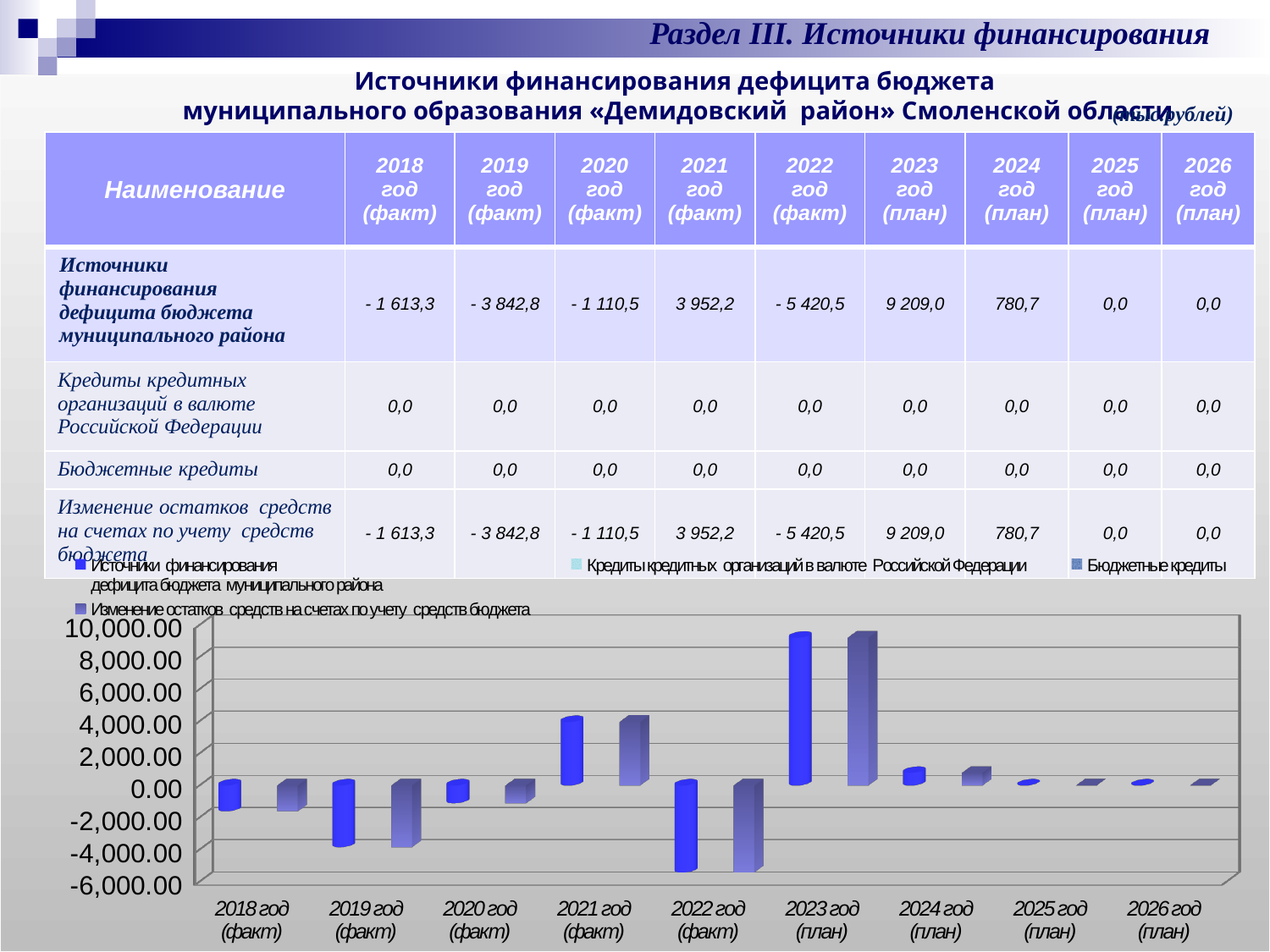
What is the highest tick value shown on the chart's vertical axis? 10,000.00 What kind of chart is shown at the bottom of the slide? bar chart In which year category do the bars reach their highest value? 2023 год (план) Is the value for 2023 год (план) greater or less than 8,000.00? greater How many series does the chart legend list? 4 Is the value for 2021 год (факт) greater or less than 2,000.00? greater According to the table, what is the value of Источники финансирования дефицита бюджета муниципального района for 2023 год (план)? 9 209,0 In which year category do the bars reach their lowest value? 2022 год (факт) Which has the larger value, 2019 год (факт) or 2020 год (факт)? 2020 год (факт) According to the table, what is the value of Изменение остатков средств на счетах по учету средств бюджета for 2022 год (факт)? - 5 420,5 How many year categories are shown along the x axis of the chart? 9 Is the value for 2022 год (факт) greater or less than -4,000.00? less